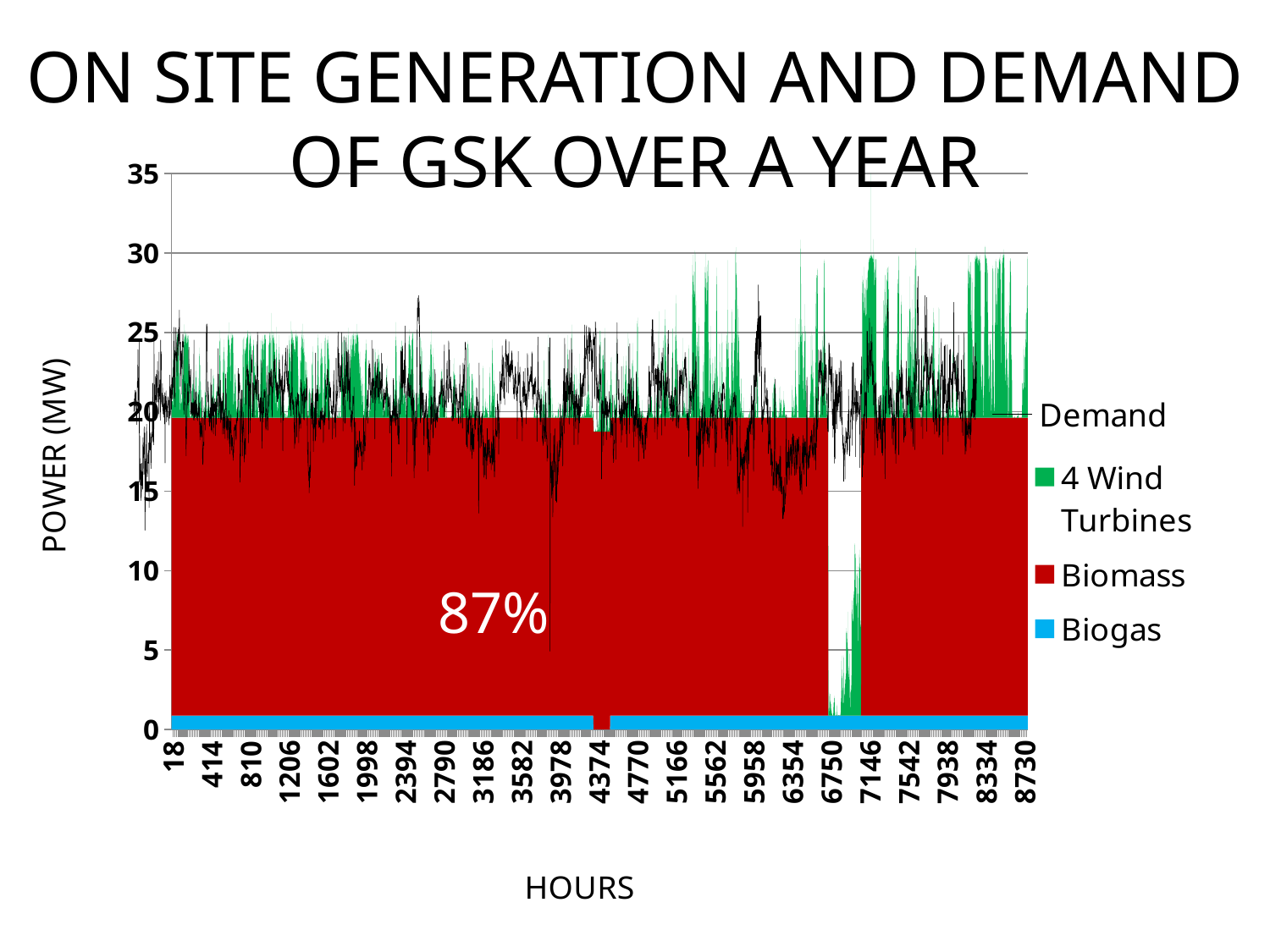
What percentage label is printed inside the Biomass area of the chart? 87% What kind of chart is shown on the slide? Stacked area chart with a line What is the last hour label shown on the x axis of the chart? 8730 How many entries does the chart legend list? 4 Is the Demand value at the start of the year (hour 18) greater or less than 10 MW? greater Does the Demand line ever go above 30 MW on the chart? No What is the first hour label shown on the x axis of the chart? 18 What is the title of the chart? ON SITE GENERATION AND DEMAND OF GSK OVER A YEAR Which series in the chart is drawn as a black line rather than a filled area? Demand Is the Biogas generation shown in the chart greater or less than 5 MW? less What colour represents Biomass in the chart? Red What is the highest value shown on the y axis of the chart? 35